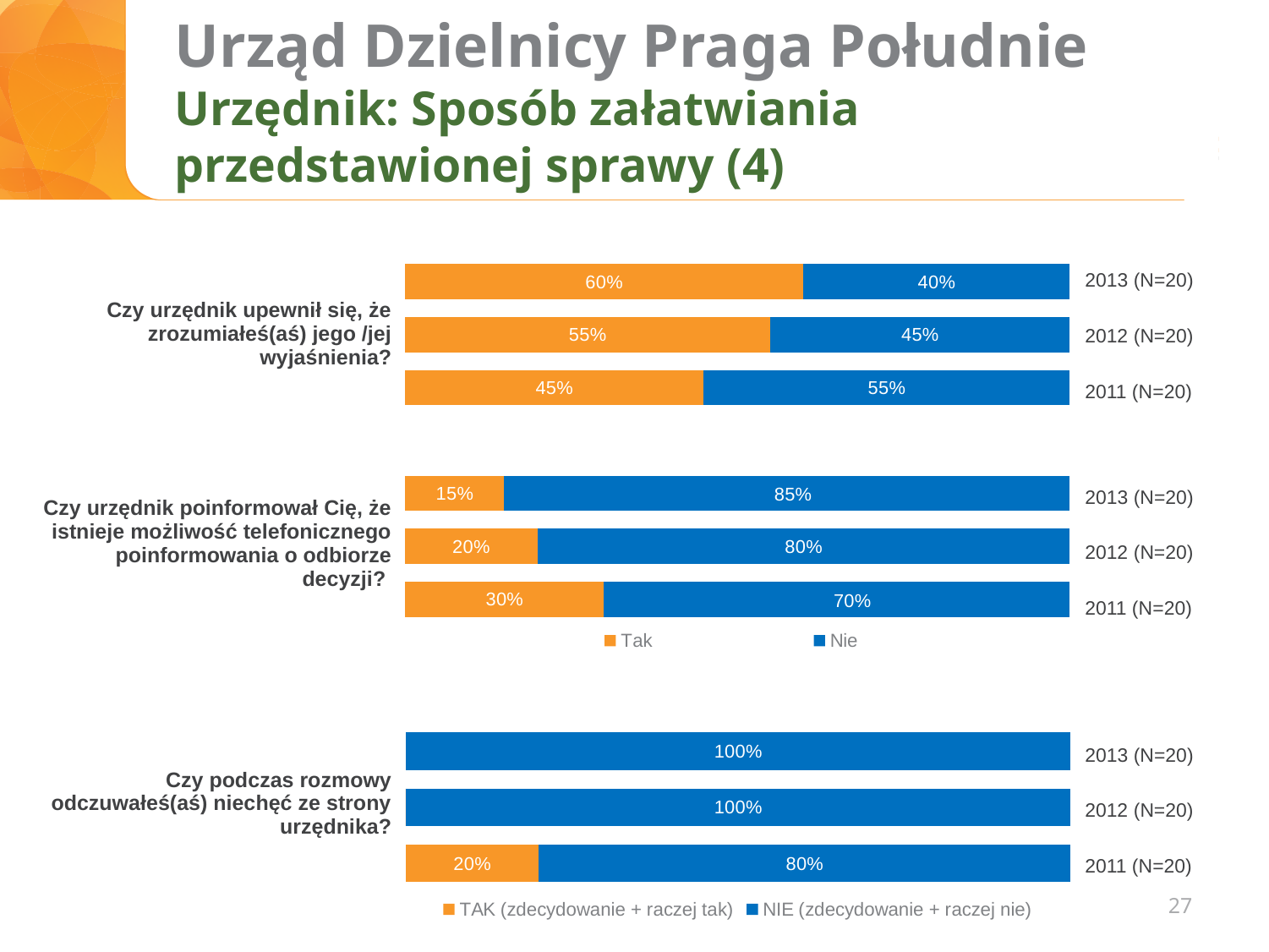
In the chart for "Czy urzędnik upewnił się, że zrozumiałeś(aś) jego /jej wyjaśnienia?", what is the Nie value for 2011 (N=20)? 55% How many series does the legend of the bottom chart list? 2 In the chart for "Czy urzędnik upewnił się, że zrozumiałeś(aś) jego /jej wyjaśnienia?", what is the Tak value for 2013 (N=20)? 60% In the chart for "Czy urzędnik poinformował Cię, że istnieje możliwość telefonicznego poinformowania o odbiorze decyzji?", which year has the lowest Tak value? 2013 (N=20) What type of chart is used for "Czy urzędnik upewnił się, że zrozumiałeś(aś) jego /jej wyjaśnienia?"? Stacked bar chart In the chart for "Czy urzędnik upewnił się, że zrozumiałeś(aś) jego /jej wyjaśnienia?", which year has the highest Tak value? 2013 (N=20) In the chart for "Czy podczas rozmowy odczuwałeś(aś) niechęć ze strony urzędnika?", what is the NIE value for 2013 (N=20)? 100% In the chart for "Czy urzędnik poinformował Cię, że istnieje możliwość telefonicznego poinformowania o odbiorze decyzji?", is the Tak value larger for 2011 or 2012? 2011 In the chart for "Czy urzędnik poinformował Cię, że istnieje możliwość telefonicznego poinformowania o odbiorze decyzji?", what is the Nie value for 2013 (N=20)? 85% In the chart for "Czy urzędnik upewnił się, że zrozumiałeś(aś) jego /jej wyjaśnienia?", what is the difference between the Tak values for 2013 and 2011? 15% How many years (bars) are shown in the chart for "Czy podczas rozmowy odczuwałeś(aś) niechęć ze strony urzędnika?"? 3 In the chart for "Czy podczas rozmowy odczuwałeś(aś) niechęć ze strony urzędnika?", what is the TAK value for 2011 (N=20)? 20%